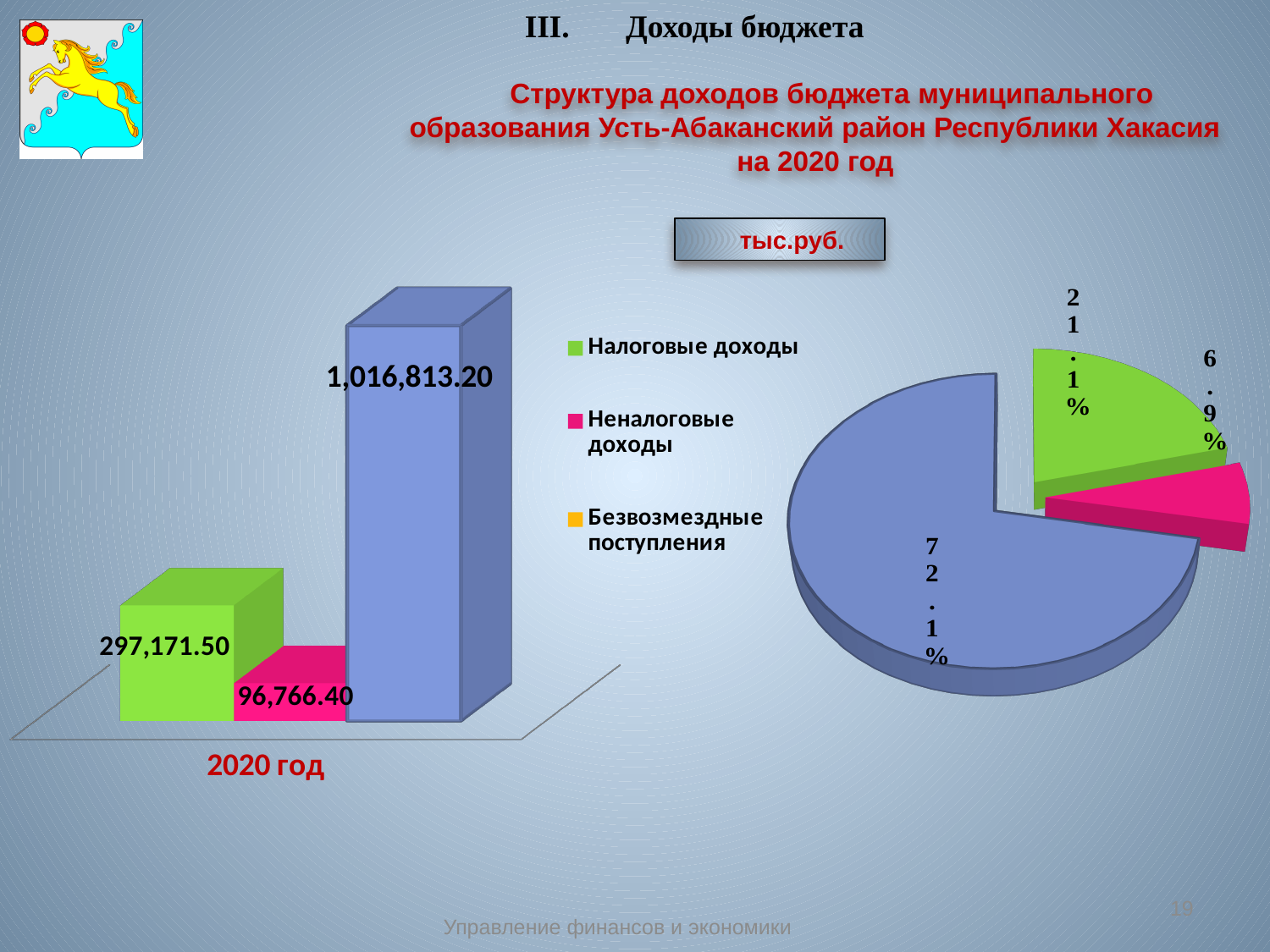
How many bars are plotted on the bar chart on the left? 3 What type of chart is shown on the right side of the slide? Pie chart On the bar chart on the left, what is the difference between the values for Налоговые доходы and Неналоговые доходы? 200,405.10 On the pie chart on the right, what share does the pink slice have? 6.9% On the bar chart on the left, which category has the lowest value? Неналоговые доходы On the pie chart on the right, what share does the largest (blue) slice have? 72.1% On the pie chart on the right, what share does the green slice have? 21.1% How many entries does the legend between the two charts list? 3 On the bar chart on the left, which is larger: Налоговые доходы or Неналоговые доходы? Налоговые доходы On the bar chart on the left, what is the value shown on the tallest (blue) bar? 1,016,813.20 On the bar chart on the left, what is the value for Налоговые доходы? 297,171.50 On the bar chart on the left, what is the value for Неналоговые доходы? 96,766.40